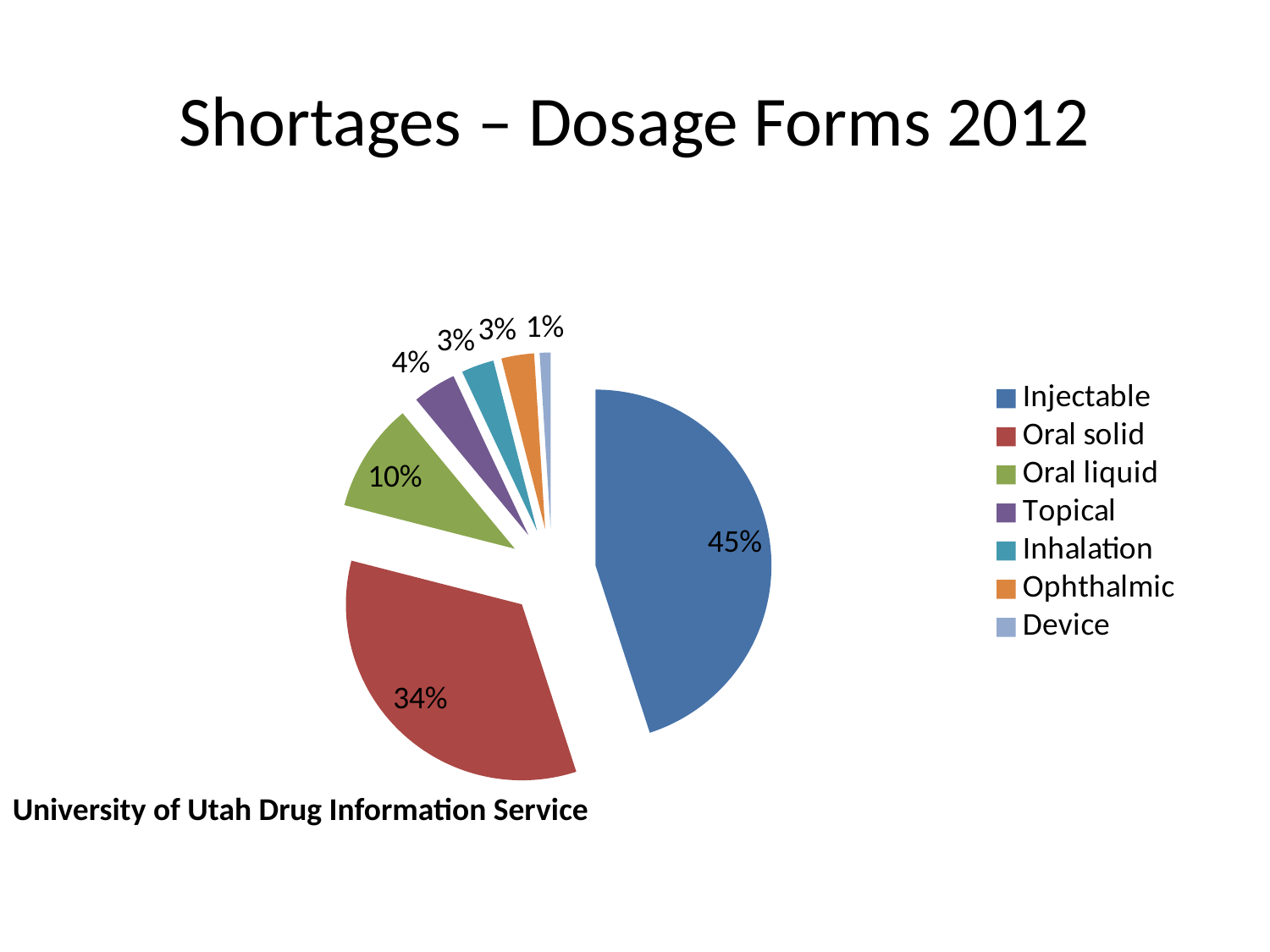
What share of the pie does Oral solid account for? 34% What is the title of the slide? Shortages – Dosage Forms 2012 Which dosage form has the smallest slice of the pie? Device What share of the pie does Injectable account for? 45% Which is larger, the share for Oral liquid or the share for Topical? Oral liquid What is the difference in percentage points between Injectable and Oral solid? 11 What is the value shown for Topical? 4% What kind of chart is shown on the slide? Pie chart How many categories does the legend list? 7 What is the value shown for Device? 1% What is the value shown for Oral liquid? 10% Which dosage form has the largest slice of the pie? Injectable